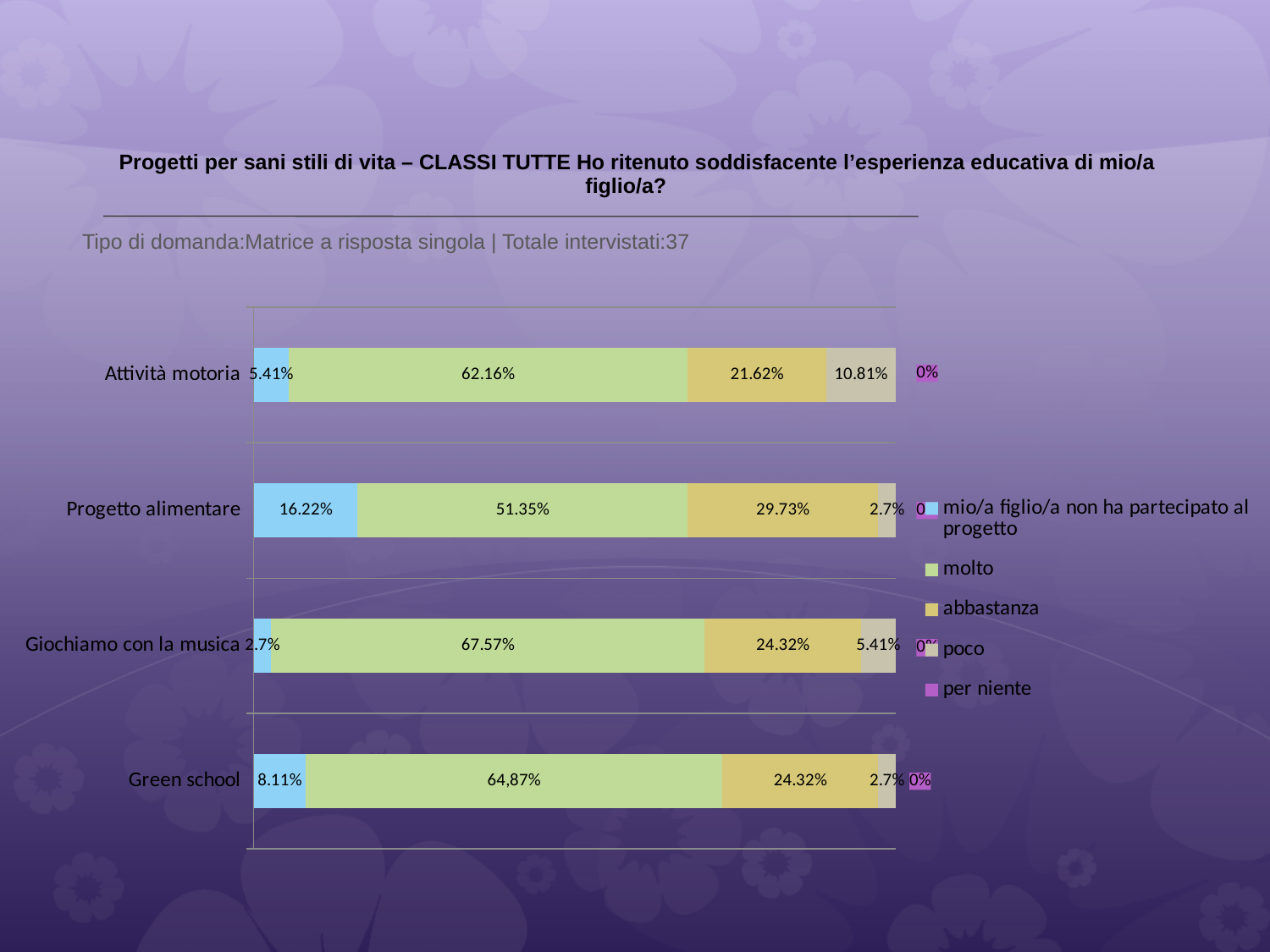
What is the 'poco' value for Attività motoria? 10.81% What is the 'molto' value for Attività motoria? 62.16% Which project has the lowest 'molto' value? Progetto alimentare What kind of chart is shown on the slide? Stacked bar chart What is the difference between the 'molto' values for Giochiamo con la musica and Attività motoria? 5.41% Which legend entry is shown in green? molto How many series does the legend list? 5 What is the value of 'mio/a figlio/a non ha partecipato al progetto' for Progetto alimentare? 16.22% Which is larger, the 'abbastanza' value for Progetto alimentare or for Green school? Progetto alimentare What is the 'abbastanza' value for Progetto alimentare? 29.73% Which project has the highest 'molto' value? Giochiamo con la musica How many categories (projects) are shown on the chart? 4